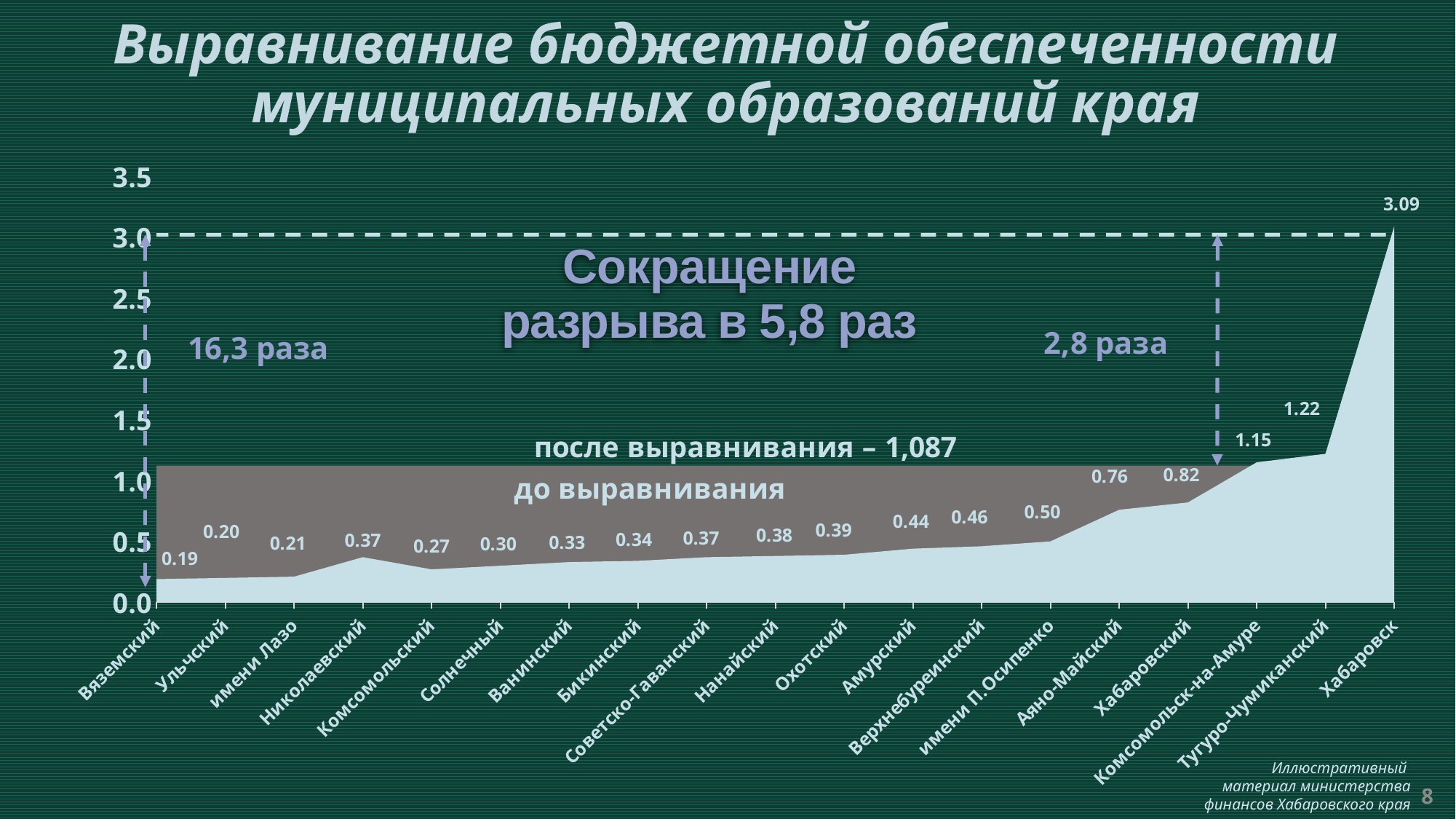
Which municipality has the lowest value before equalization? Вяземский What is the value for Тугуро-Чумиканский before equalization? 1.22 What level is shown for the series after equalization (после выравнивания)? 1,087 Do the values before equalization rise or fall from left to right along the x axis? Rise Which municipality has the highest value before equalization? Хабаровск What kind of chart is shown on the slide? Area chart What is the value for Хабаровск before equalization (до выравнивания)? 3.09 What is the value for Николаевский before equalization? 0.37 What is the value for Вяземский before equalization? 0.19 How many municipalities are shown on the x axis of the chart? 19 What is the difference between the values for Хабаровск and Вяземский before equalization? 2.90 Which has a larger value before equalization, Аяно-Майский or Хабаровский? Хабаровский